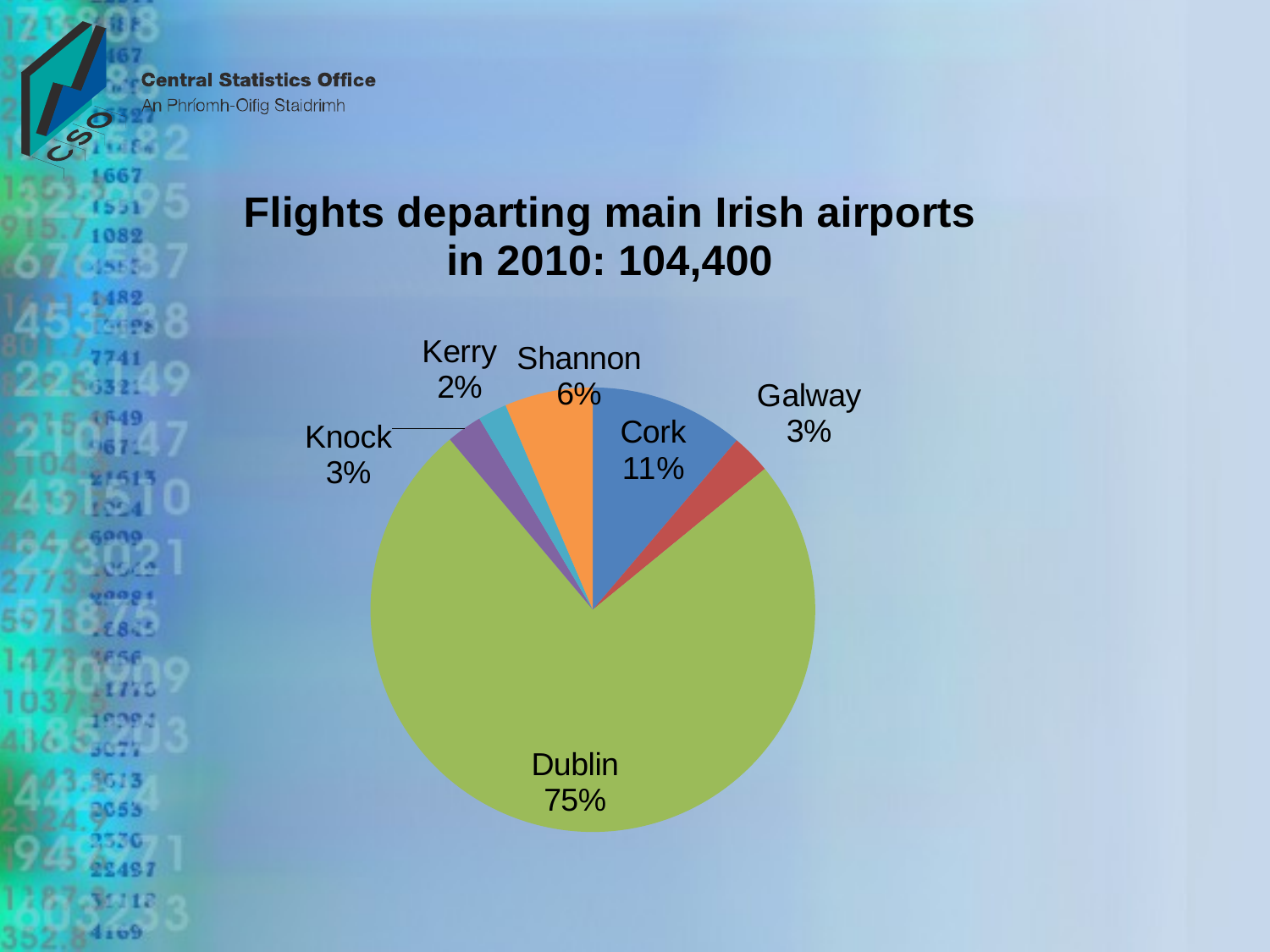
Which airport has the largest share of departing flights? Dublin Which airport has the smallest share of departing flights? Kerry What share of flights departed from Shannon? 6% How many airports are shown in the pie chart? 6 What kind of chart is shown on the slide? pie chart What is the difference in percentage points between Dublin's share and Cork's share? 64 What share of flights departed from Cork? 11% What share of flights departed from Kerry? 2% What share of flights departed from Dublin? 75% Which has a larger share, Cork or Shannon? Cork What is the total number of flights departing main Irish airports in 2010, as stated in the chart title? 104,400 What is the title of the chart? Flights departing main Irish airports in 2010: 104,400